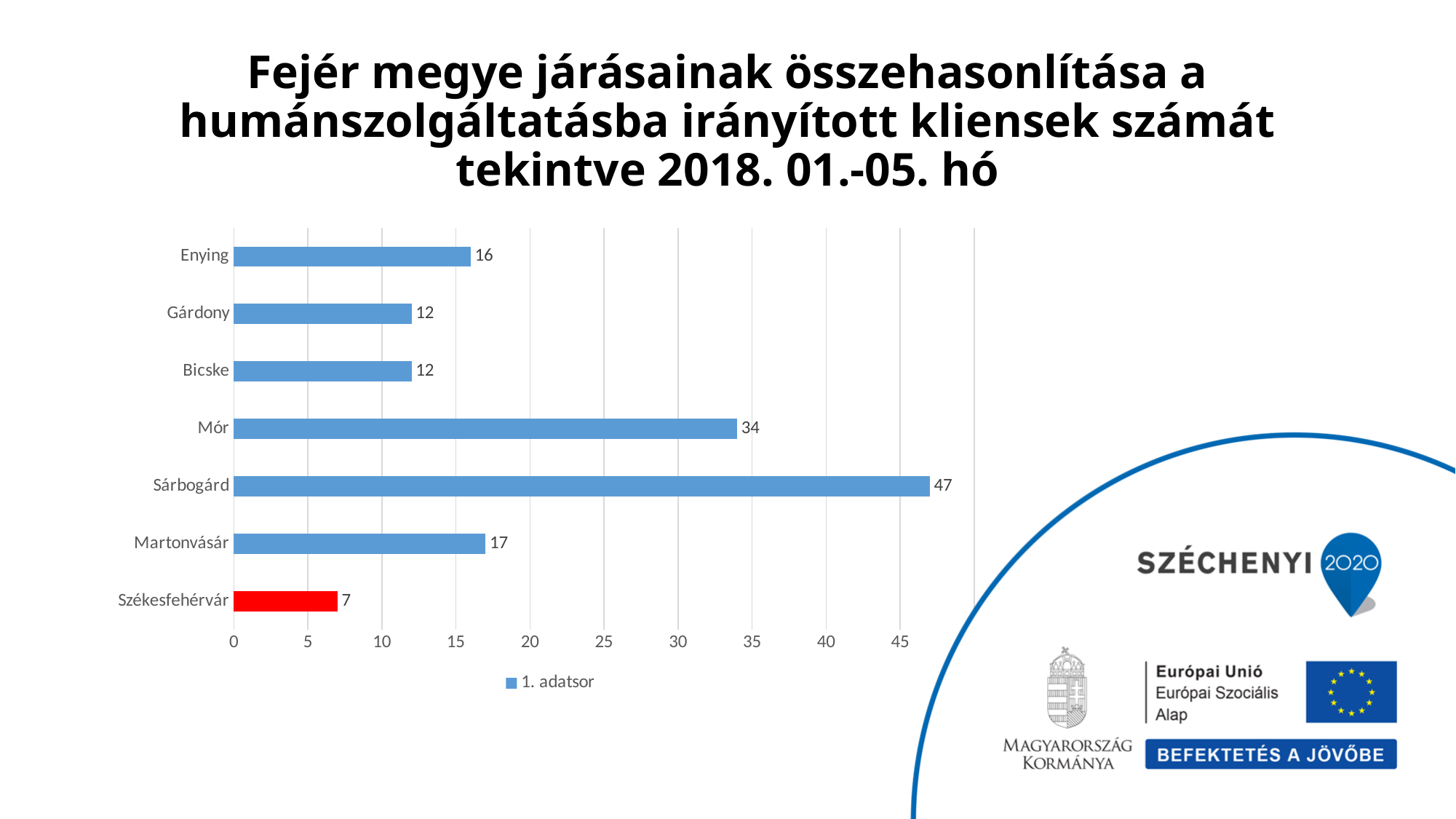
What is the value for Mór? 34 Is the value for Mór greater or less than 30? greater What kind of chart is shown on the slide? bar chart What is the value for Székesfehérvár? 7 What is the value for Sárbogárd? 47 Which category has the highest value? Sárbogárd Which is larger, the value for Enying or the value for Martonvásár? Martonvásár How many categories are shown in the chart? 7 Which category's bar is coloured red? Székesfehérvár How many series does the legend list? 1 Which category has the lowest value? Székesfehérvár What is the difference between the values for Sárbogárd and Mór? 13